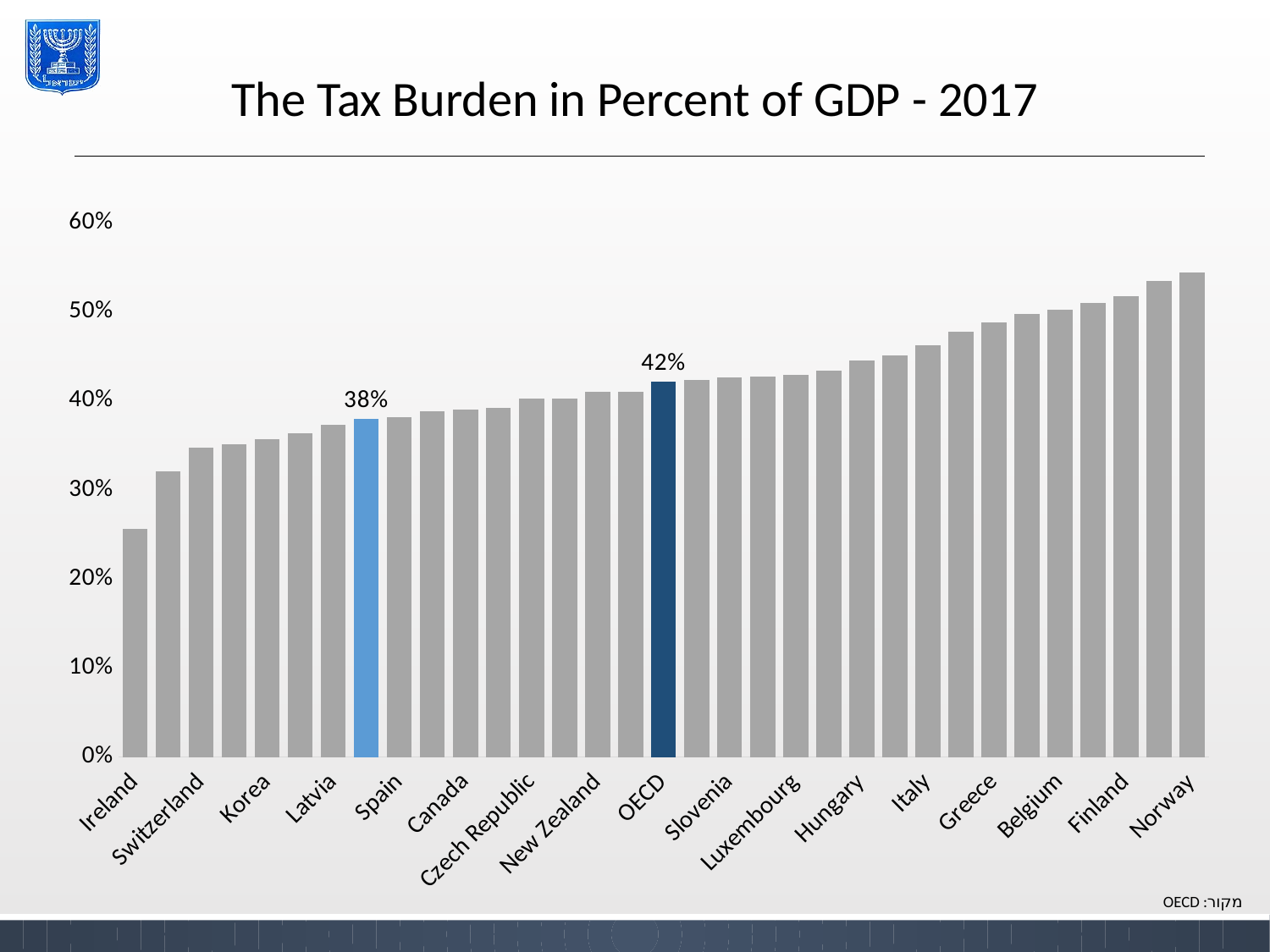
What value is labeled on the OECD bar? 42% Which has a larger value, Norway or Ireland? Norway What value is labeled on the light blue highlighted bar? 38% What is the title of the chart? The Tax Burden in Percent of GDP - 2017 Is the value for Ireland greater or less than 30%? less Is the value for Norway greater or less than 50%? greater What kind of chart is shown on the slide? bar chart Do the bar values rise or fall from left to right along the x axis? rise Which country has the lowest tax burden in the chart? Ireland What is the difference between the OECD bar's value and the light blue highlighted bar's value? 4 percentage points Is the value for Italy greater or less than 40%? greater Which country has the highest tax burden in the chart? Norway